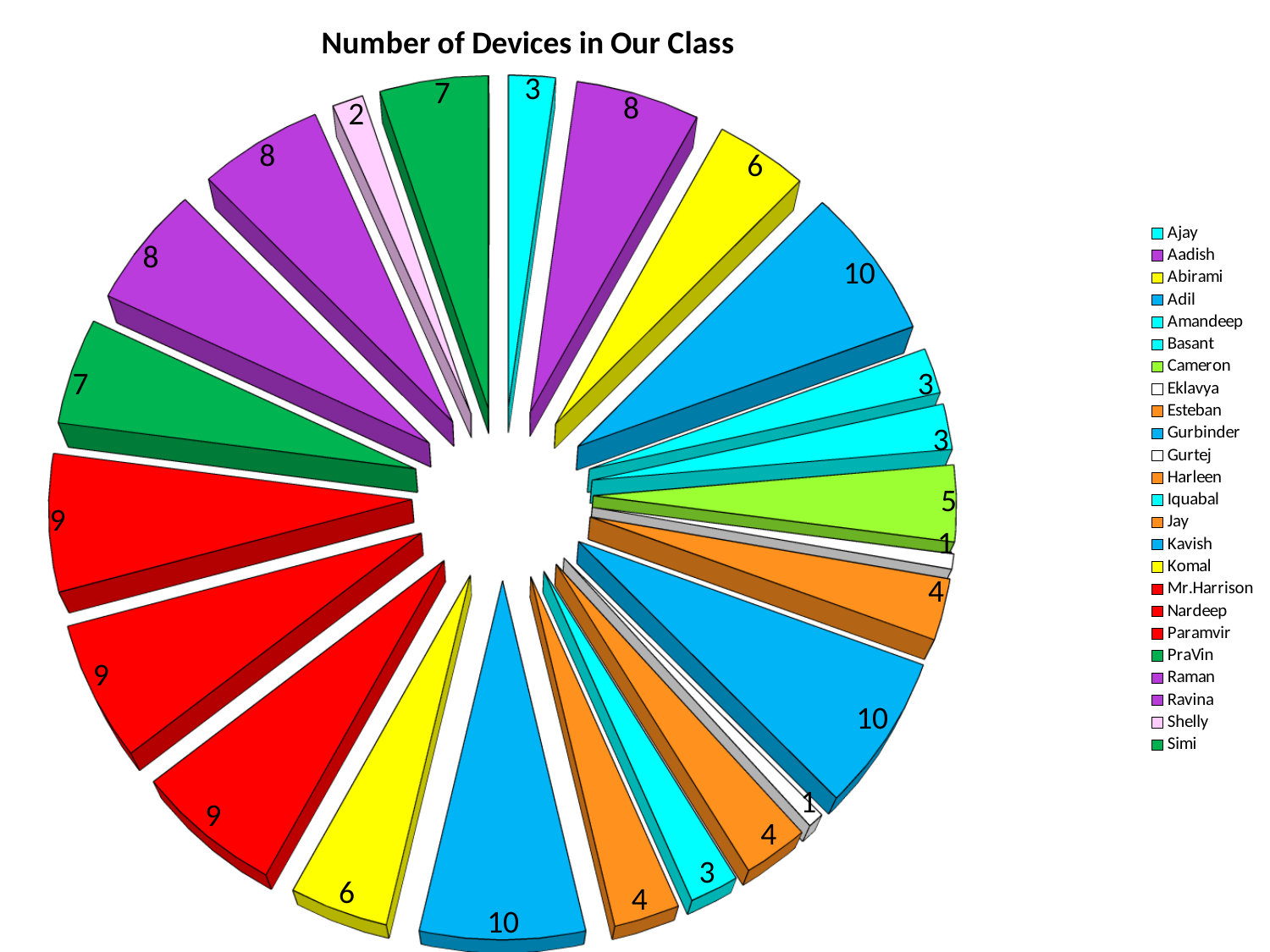
What is the smallest value shown on any slice of the pie? 1 How many devices does Mr.Harrison have? 9 What is the largest value shown on any slice of the pie? 10 What is the title of the chart? Number of Devices in Our Class How many slices does the pie chart have? 24 How many devices does Cameron have? 5 How many devices does Kavish have? 10 How many devices does Shelly have? 2 How many entries does the legend list? 24 What is the difference between Cameron's value and Shelly's value? 3 Who has more devices, Cameron or Shelly? Cameron What type of chart is shown on the slide? pie chart